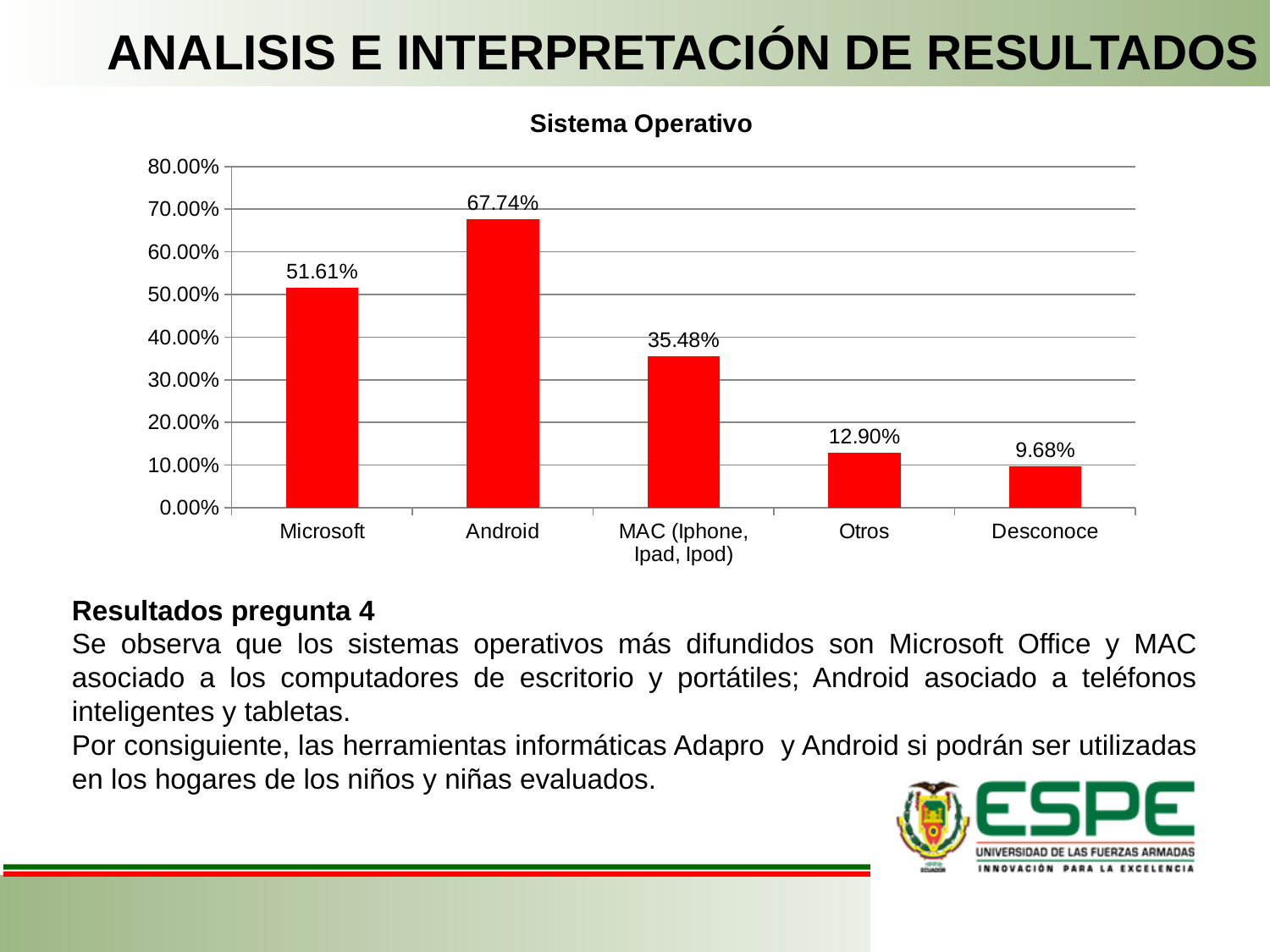
What is the value for Android in the Sistema Operativo chart? 67.74% Which category has the lowest value in the Sistema Operativo chart? Desconoce Which is larger in the Sistema Operativo chart, the value for Otros or the value for Desconoce? Otros What is the title of the chart on the slide? Sistema Operativo Which category has the highest value in the Sistema Operativo chart? Android What is the value for Microsoft in the Sistema Operativo chart? 51.61% What is the value for MAC (Iphone, Ipad, Ipod) in the Sistema Operativo chart? 35.48% What kind of chart is the Sistema Operativo chart? Bar chart How many categories are shown in the Sistema Operativo chart? 5 Is the value for Microsoft in the Sistema Operativo chart greater or less than 50.00%? greater What is the difference between the values for Android and Microsoft in the Sistema Operativo chart? 16.13% What is the value for Desconoce in the Sistema Operativo chart? 9.68%